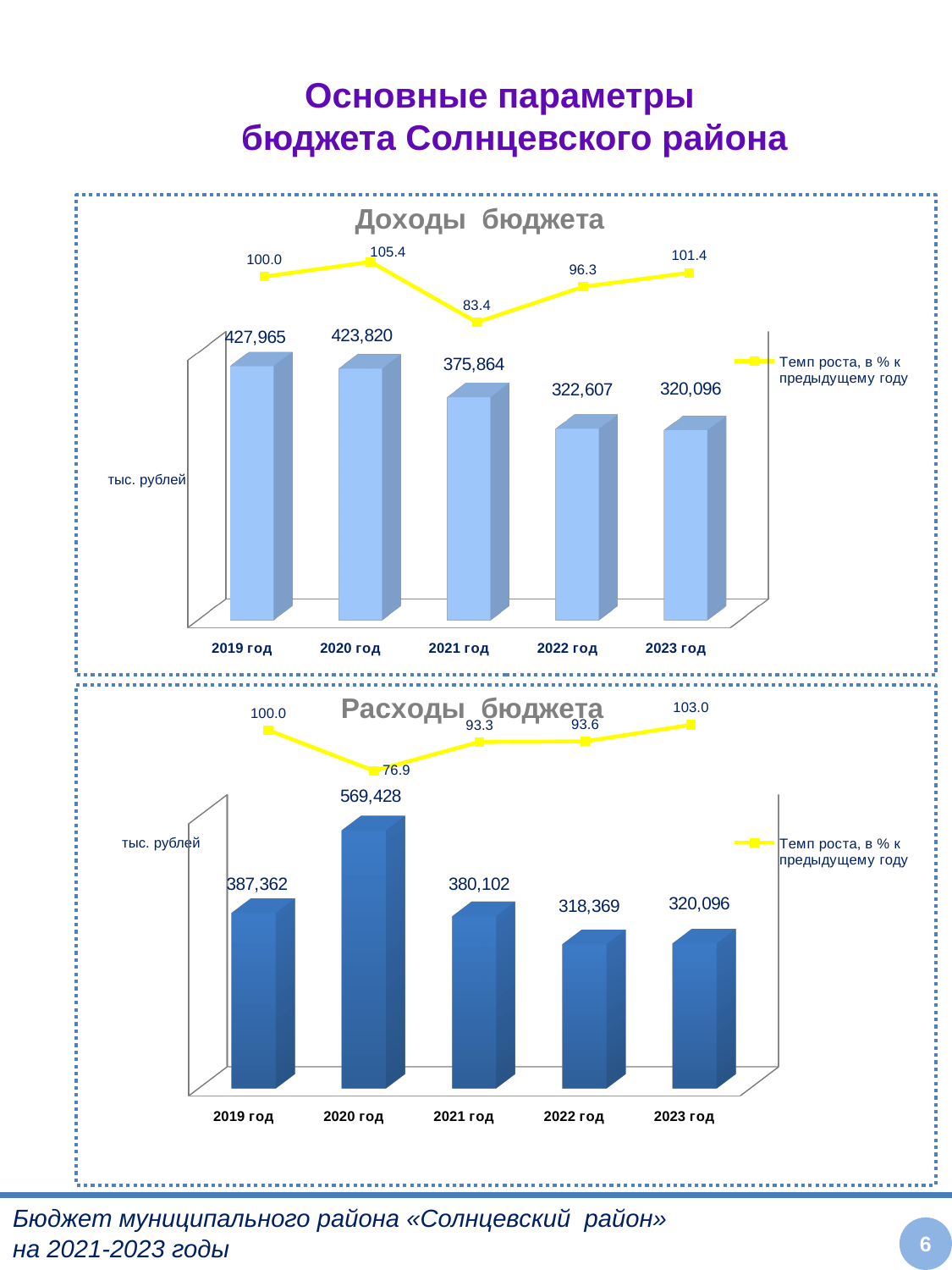
In the 'Расходы бюджета' chart, what is the value for 2020 год? 569,428 In the 'Доходы бюджета' chart, do the bar values rise or fall from 2019 год to 2023 год? fall In the 'Доходы бюджета' chart, which year has the highest bar? 2019 год In the 'Доходы бюджета' chart, what is the value for 2021 год? 375,864 In the 'Расходы бюджета' chart, which year has the lowest bar? 2022 год In the 'Расходы бюджета' chart, which is larger, the bar for 2019 год or the bar for 2021 год? 2019 год What type of chart is the 'Доходы бюджета' chart? Bar chart with a line How many years (categories) are shown on the x axis of the 'Расходы бюджета' chart? 5 In the 'Расходы бюджета' chart, what is the difference between the 2020 год and 2021 год bar values? 189,326 In the 'Доходы бюджета' chart, what is the difference between the 2019 год and 2023 год bar values? 107,869 In the 'Расходы бюджета' chart, what is the growth rate (Темп роста) value shown for 2020 год? 76.9 In the 'Доходы бюджета' chart, what is the growth rate (Темп роста) value shown for 2021 год? 83.4